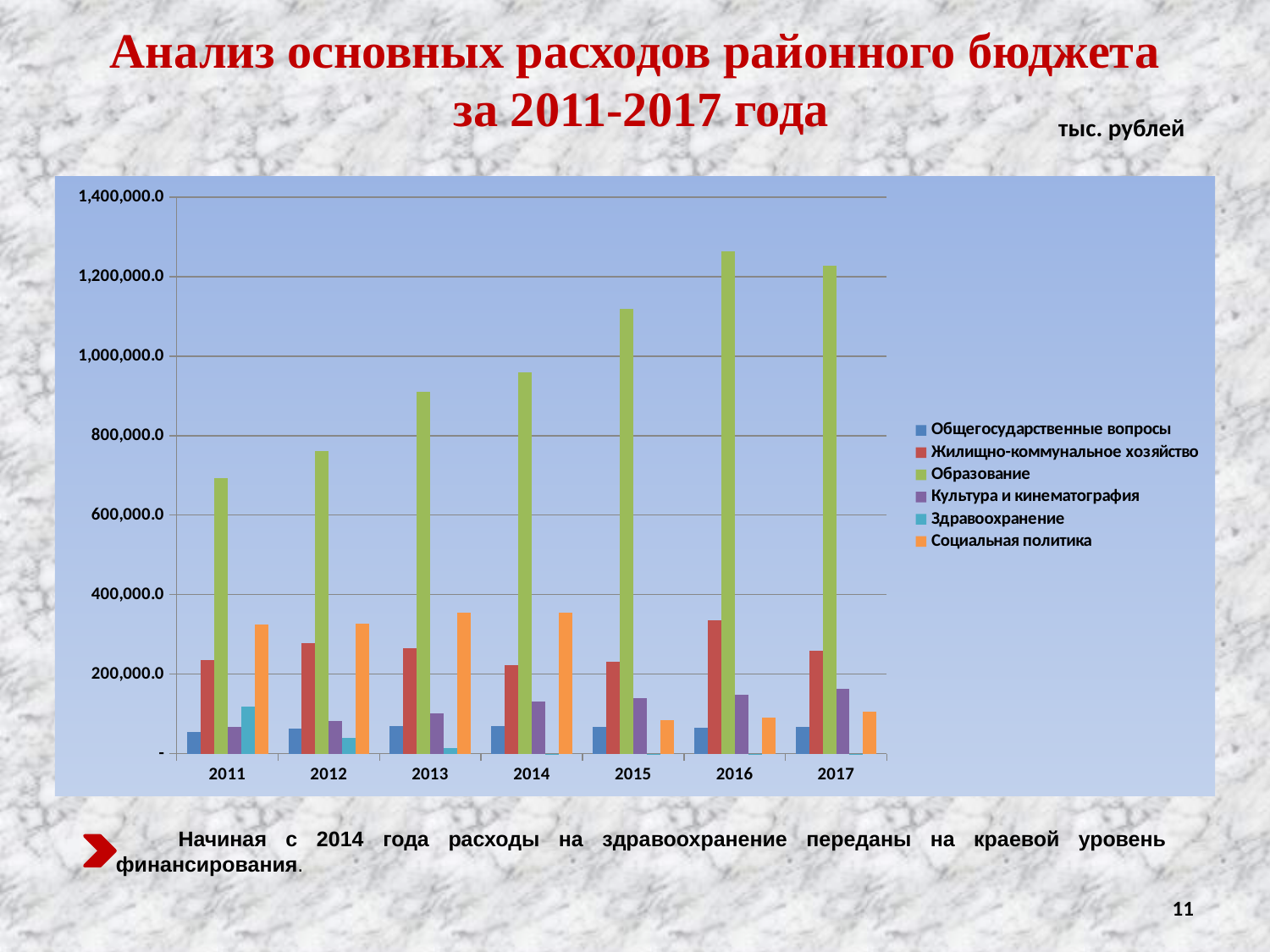
Is the value for Образование in 2015 greater or less than 1,000,000.0? greater Is the value for Жилищно-коммунальное хозяйство in 2016 greater or less than 400,000.0? less Do the values for Культура и кинематография rise or fall from 2011 to 2017? rise What kind of chart is shown on the slide? bar chart Which is larger in 2011: Социальная политика or Жилищно-коммунальное хозяйство? Социальная политика How many years are shown on the x axis? 7 Which series has the highest value in 2016? Образование Which is larger: Социальная политика in 2014 or Социальная политика in 2015? 2014 In which year is the value for Образование the highest? 2016 How many series does the legend list? 6 In which year is the value for Здравоохранение the highest? 2011 Is the value for Образование in 2011 greater or less than 600,000.0? greater